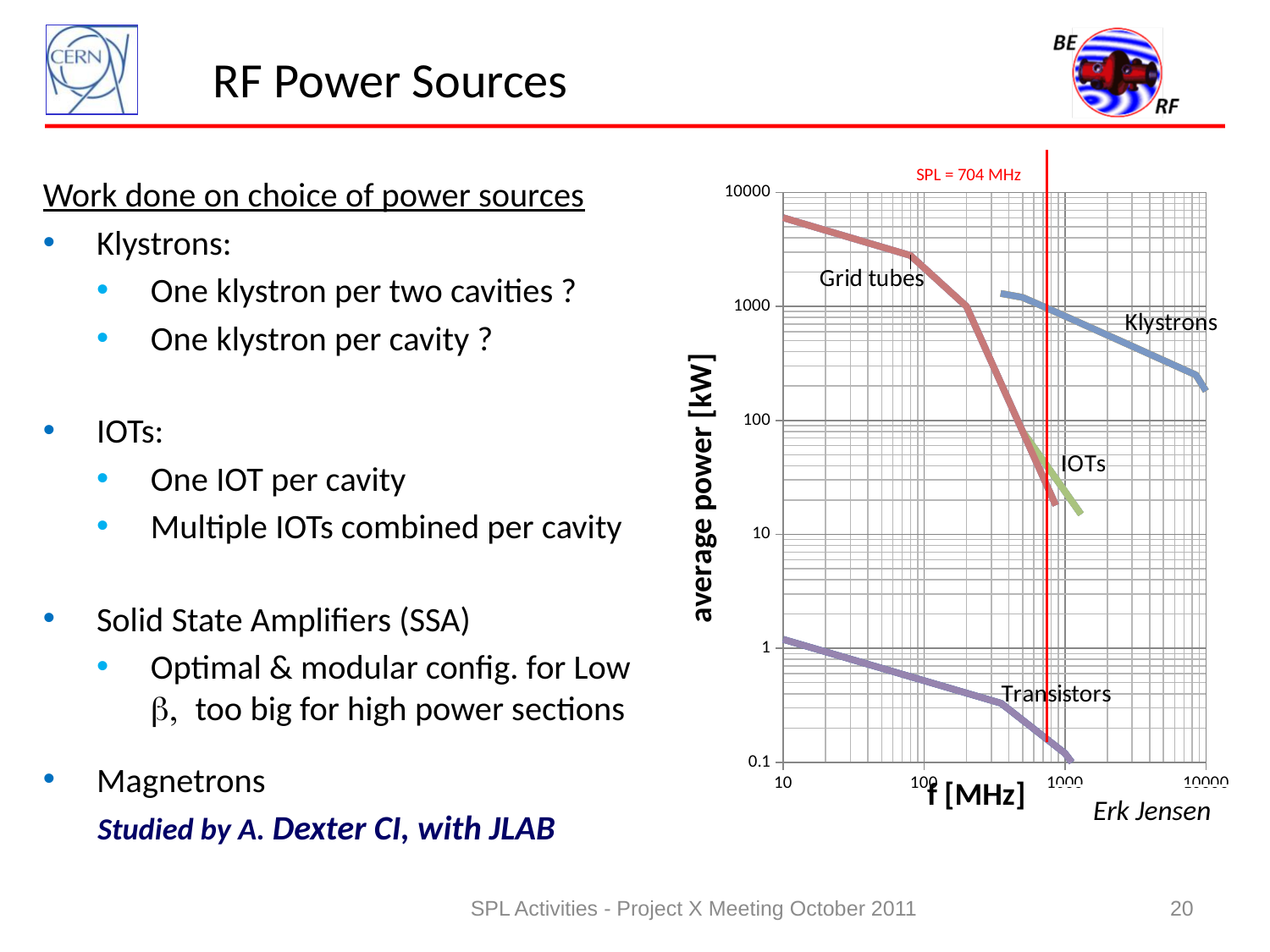
Which curve has the lowest average power on the chart? Transistors What is the label of the vertical axis of the chart? average power [kW] Does the Grid tubes curve rise or fall as frequency increases? fall Is the average power of the Klystrons curve at 10000 MHz greater or less than 1000 kW? less What kind of chart is shown on the slide? line chart Is the average power of the Grid tubes curve at 10 MHz greater or less than 1000 kW? greater Which curve reaches the highest average power on the chart? Grid tubes Does the Transistors curve rise or fall as frequency increases? fall How many technology curves are plotted on the chart? 4 Is the average power of the Transistors curve at 100 MHz greater or less than 1 kW? less At the SPL frequency of 704 MHz, which curve shows higher average power, Klystrons or IOTs? Klystrons What frequency does the vertical red line on the chart mark? SPL = 704 MHz